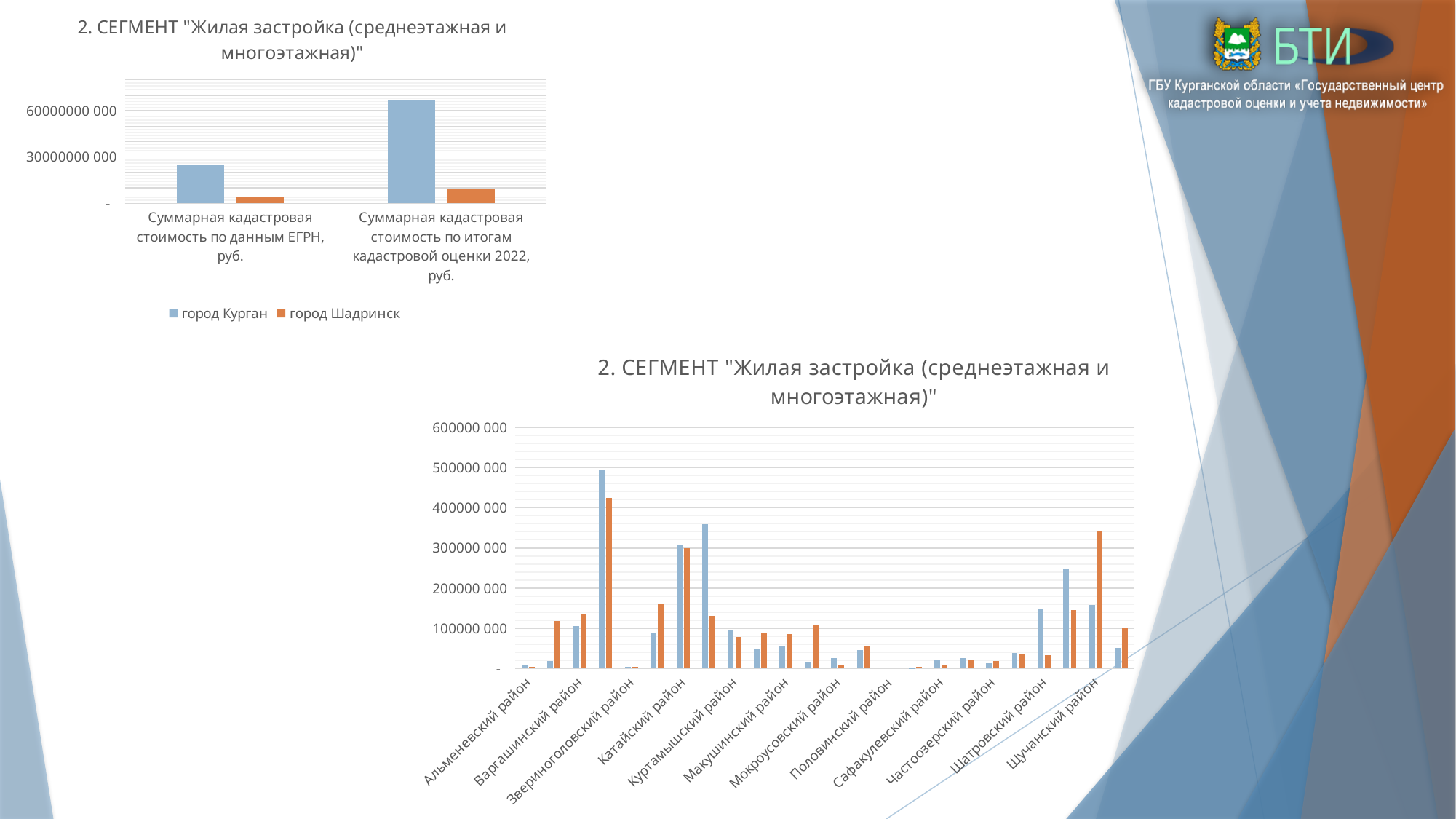
In the bottom-right chart, for Щучанский район, is the blue bar or the orange bar taller? orange In the bottom-right chart, is the blue bar for Звериноголовский район greater or less than 400000 000? less In the top-left chart, which series has the larger value for 'Суммарная кадастровая стоимость по итогам кадастровой оценки 2022, руб.': город Курган or город Шадринск? город Курган Which series does the legend of the top-left chart list? город Курган, город Шадринск In the bottom-right chart, is the blue bar for Куртамышский район greater or less than 300000 000? less How many categories are shown on the x axis of the top-left chart? 2 In the top-left chart, is the value for город Курган in 'Суммарная кадастровая стоимость по итогам кадастровой оценки 2022, руб.' greater or less than 60000000 000? greater What kind of chart is the top-left chart? bar chart How many series does the legend of the top-left chart list? 2